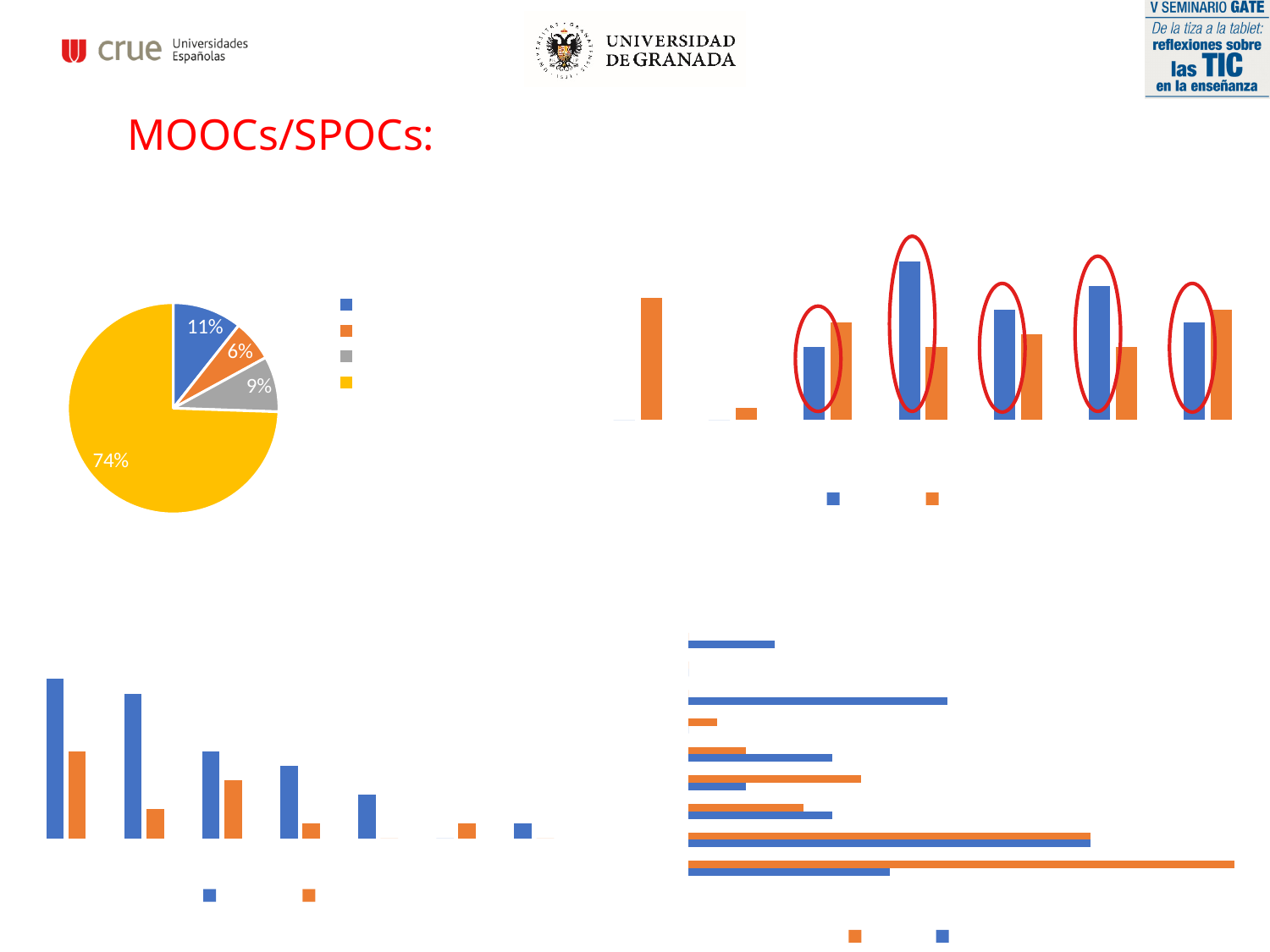
In the top-left pie chart, what percentage is shown on the blue slice? 11% What kind of chart is the top-left chart on the slide? pie chart In the top-left pie chart, what is the share of the largest slice? 74% How many series does the legend of the top-right bar chart list? 2 In the top-left pie chart, what percentage is shown on the yellow slice? 74% In the top-left pie chart, what is the difference between the largest slice (74%) and the smallest slice (6%)? 68% What kind of chart is the top-right chart on the slide? bar chart In the top-left pie chart, what is the share of the smallest slice? 6% How many entries does the legend of the top-left pie chart list? 4 How many slices does the top-left pie chart have? 4 In the top-left pie chart, which slice is larger, the blue slice or the grey slice? the blue slice (11%) In the bottom-left bar chart, do the blue bars rise or fall from left to right? fall